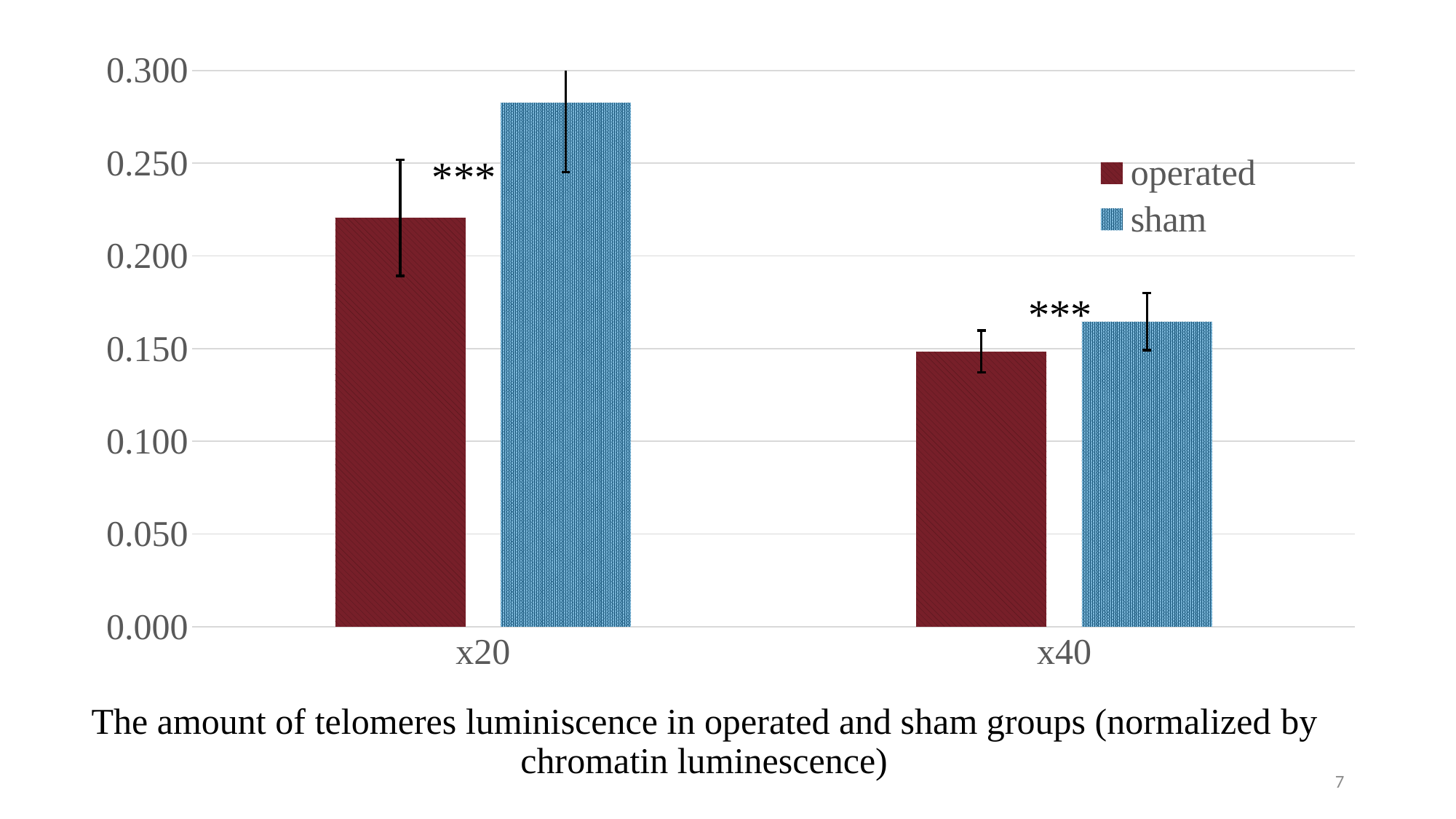
Is the value for sham at x20 greater or less than 0.250? greater Is the value for sham at x40 greater or less than 0.200? less Which series and category has the lowest bar? operated at x40 At x40, which is larger, the operated bar or the sham bar? sham What kind of chart is shown on the slide? bar chart How many categories are shown on the x axis? 2 At x20, which is larger, the operated bar or the sham bar? sham What colour are the bars for the sham series? blue Which series and category has the highest bar? sham at x20 Is the value for operated at x20 greater or less than 0.200? greater How many series does the legend list? 2 Does the operated series rise or fall from x20 to x40? fall